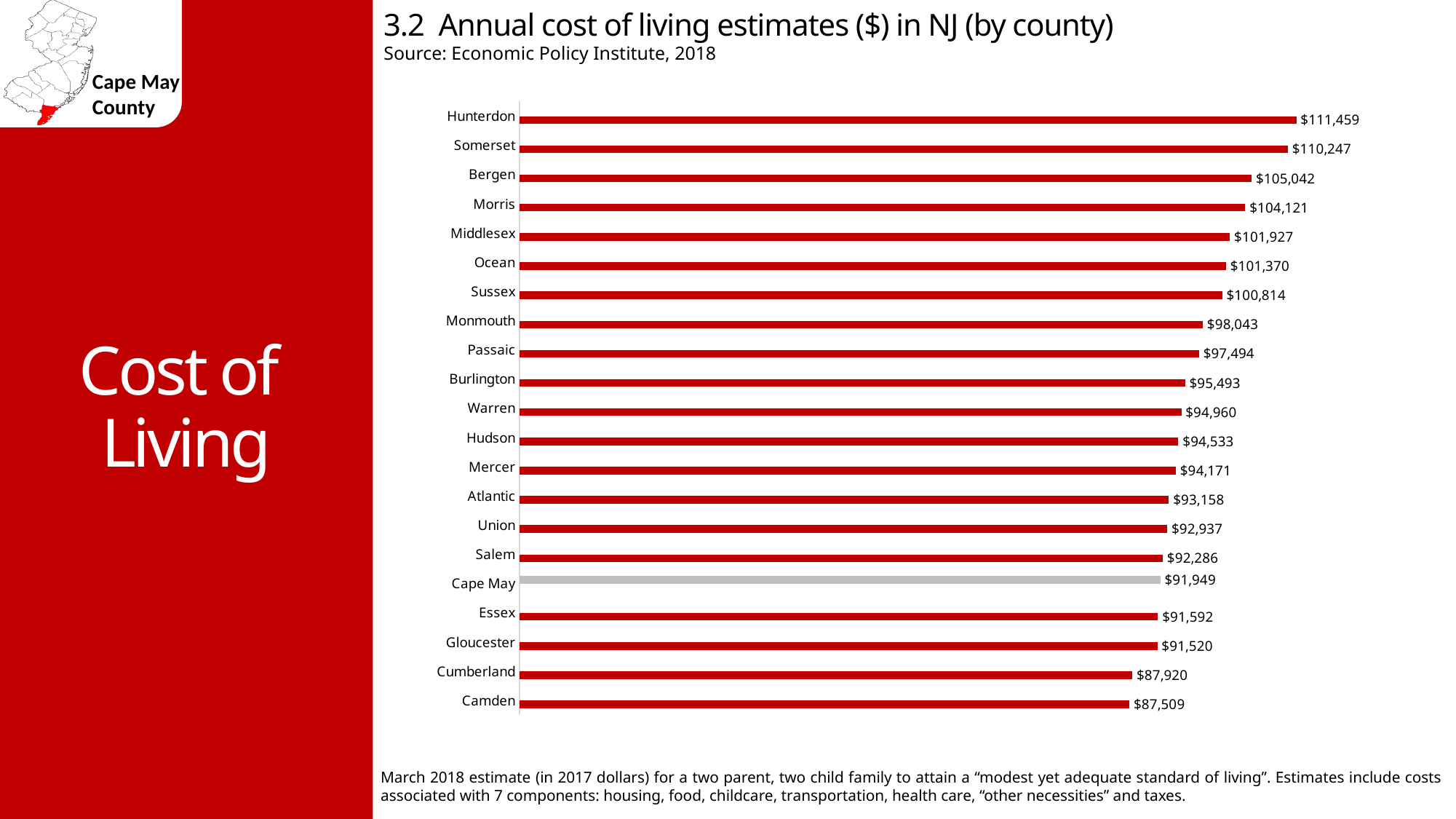
Which county has the lowest annual cost of living estimate? Camden What is the difference between the cost of living estimates for Salem and Cape May? $337 What type of chart is used on this slide? Bar chart What is the annual cost of living estimate for Cape May county? $91,949 Which county's bar is shown in gray instead of red? Cape May What is the difference between the cost of living estimates for Hunterdon and Camden? $23,950 Which county has a higher cost of living estimate, Cumberland or Gloucester? Gloucester How many counties are shown in the chart? 21 Which county has a higher cost of living estimate, Bergen or Morris? Bergen What is the annual cost of living estimate for Atlantic county? $93,158 Which county has the highest annual cost of living estimate? Hunterdon What is the annual cost of living estimate for Hunterdon county? $111,459